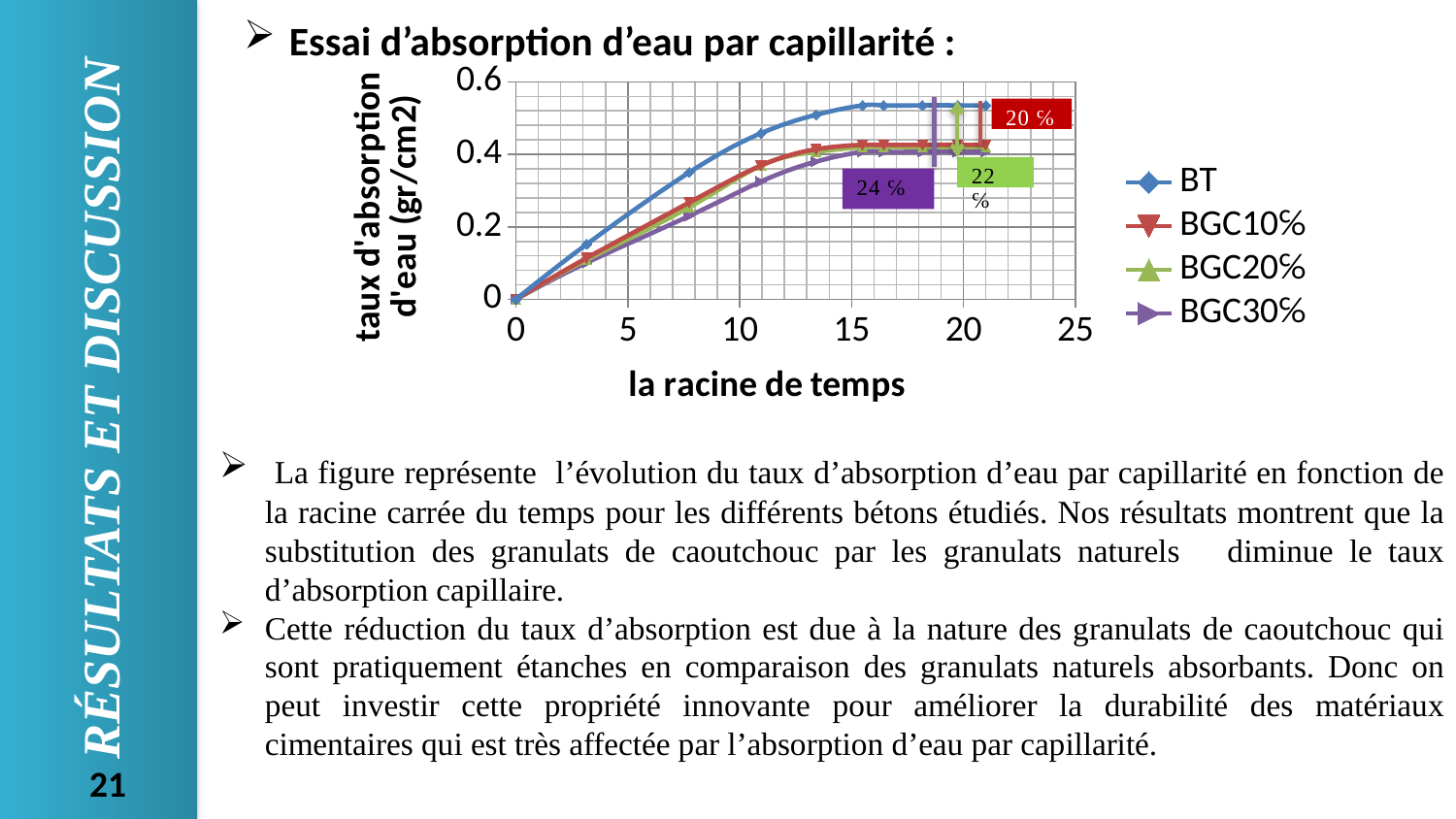
What kind of chart is shown on the slide? line chart Which series has the highest water absorption rate across the chart? BT What is the maximum value shown on the y axis of the chart? 0.6 Is the value of the BGC10% series at 'la racine de temps' = 20 greater or less than 0.6? less What is the title of the y axis of the chart? taux d'absorption d'eau (gr/cm2) At 'la racine de temps' = 10, which series has the larger value, BT or BGC30%? BT How many series does the chart legend list? 4 What is the maximum value shown on the x axis of the chart? 25 What is the title of the x axis of the chart? la racine de temps Do the values of the BT series rise or fall as 'la racine de temps' increases? rise Is the value of the BGC30% series at 'la racine de temps' = 5 greater or less than 0.2? less Is the plateau value of the BT series greater or less than 0.4? greater